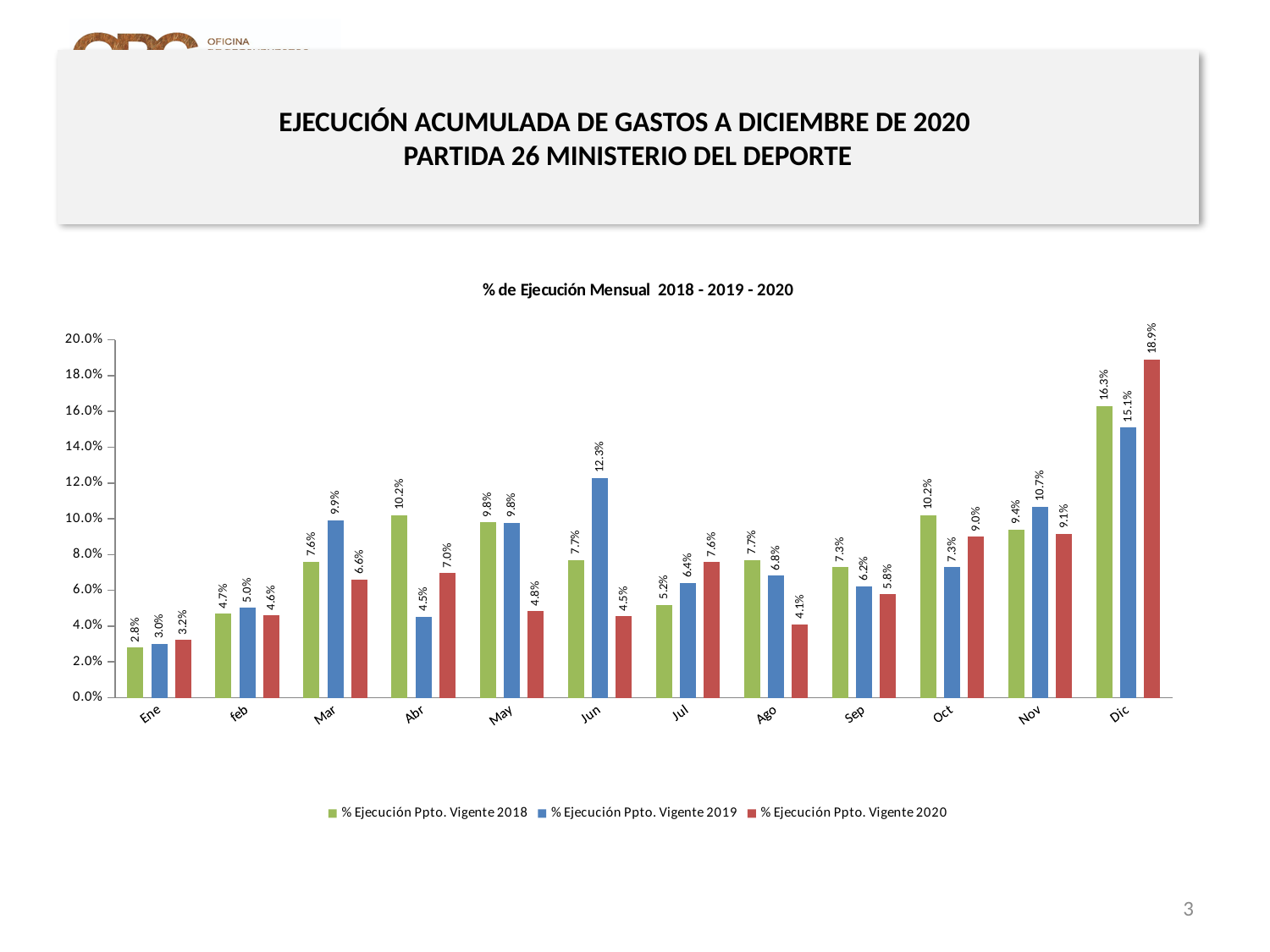
What is the value for % Ejecución Ppto. Vigente 2019 in Jun? 12.3% What is the difference between the 2020 and 2019 values in Dic? 3.8% What is the value for % Ejecución Ppto. Vigente 2018 in Abr? 10.2% In Mar, which series has the larger value: % Ejecución Ppto. Vigente 2019 or % Ejecución Ppto. Vigente 2020? % Ejecución Ppto. Vigente 2019 Which month has the lowest value for % Ejecución Ppto. Vigente 2018? Ene Is the value for % Ejecución Ppto. Vigente 2019 in Nov greater or less than 10.0%? greater Which month has the highest value for % Ejecución Ppto. Vigente 2020? Dic What kind of chart is shown on the slide? Bar chart What is the title of the chart? % de Ejecución Mensual 2018 - 2019 - 2020 How many months are shown on the x axis? 12 What is the value for % Ejecución Ppto. Vigente 2020 in Dic? 18.9% How many series does the legend list? 3